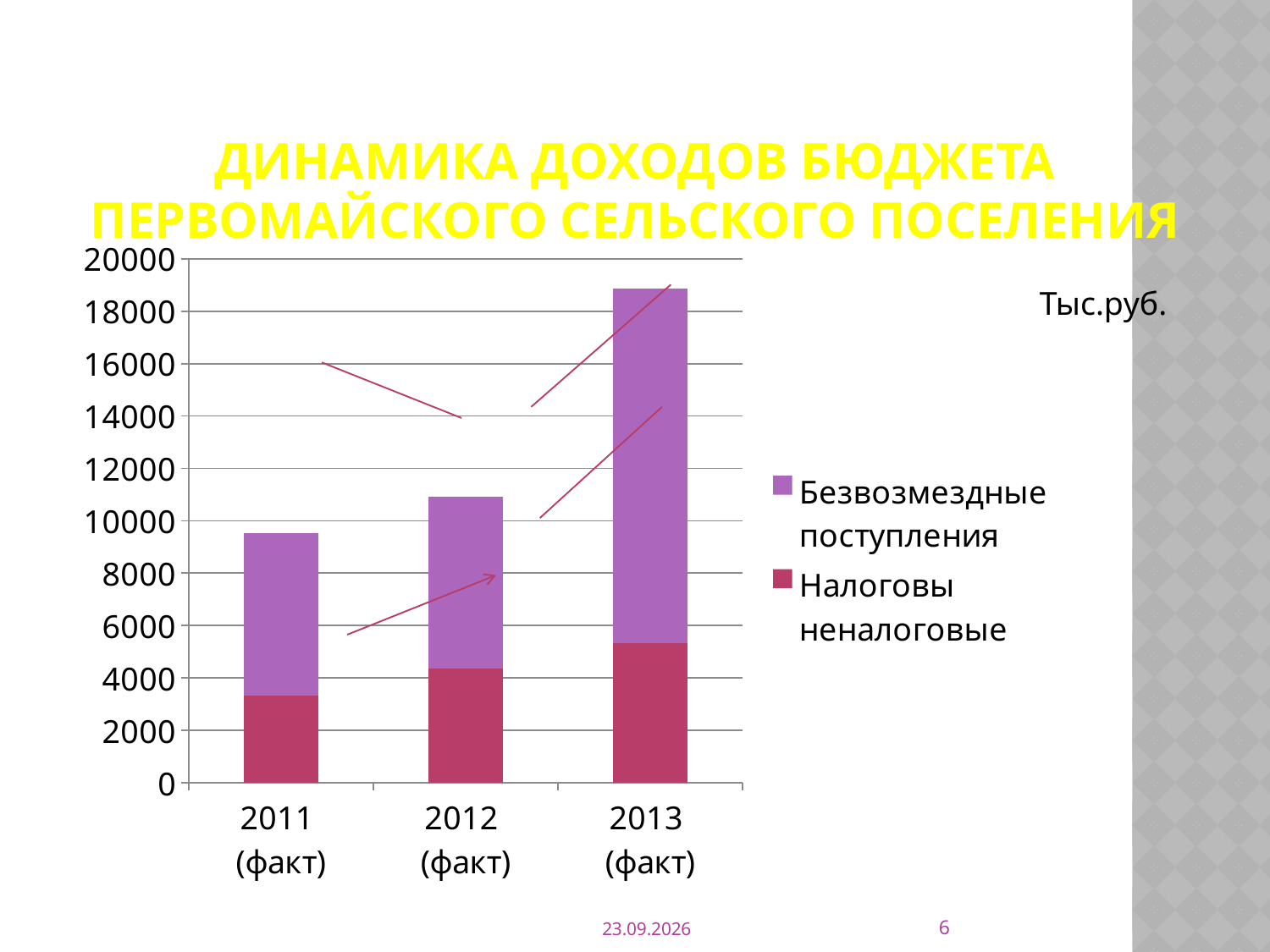
Is the total for 2013 (факт) greater or less than 18000? greater Which is larger in 2013 (факт): Безвозмездные поступления or Налоговы неналоговые? Безвозмездные поступления Which series is shown in the lighter purple colour? Безвозмездные поступления What kind of chart is shown on the slide? stacked bar chart Which year has the highest total budget income? 2013 (факт) How many series does the legend list? 2 What unit of measurement is indicated next to the chart? Тыс.руб. How many years (categories) are shown on the x axis? 3 Do the total budget incomes rise or fall from 2011 to 2013? rise Is the total for 2011 (факт) greater or less than 10000? less Which year has the lowest total budget income? 2011 (факт) Is the value of Налоговы неналоговые for 2012 (факт) greater or less than 4000? greater